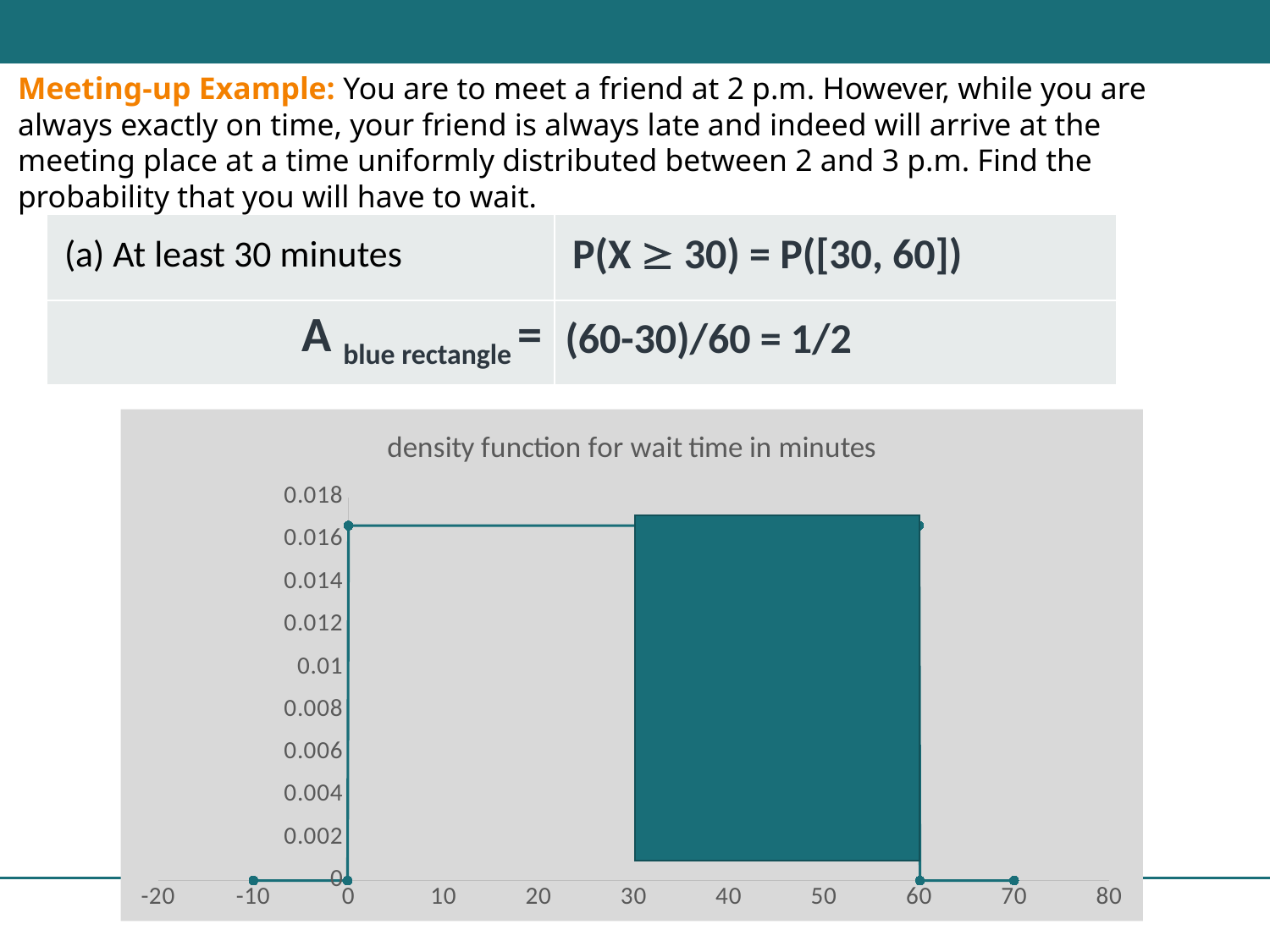
What kind of chart is shown on the slide? line chart Which is larger, the density at x = 20 or the density at x = 70? x = 20 What is the title of the chart? density function for wait time in minutes Between which two x-axis values does the shaded rectangle extend? 30 and 60 What is the value of the density function at x = 70? 0 What is the highest tick label shown on the y axis? 0.018 Is the value of the density function at x = 30 greater or less than 0.01? greater Is the value of the density function at x = 10 greater or less than 0.014? greater Is the value of the density function at x = 50 greater or less than 0.018? less Does the density function rise or fall as x goes from 60 to 70? fall How many tick labels are shown on the x axis? 11 What is the value of the density function at x = -10? 0